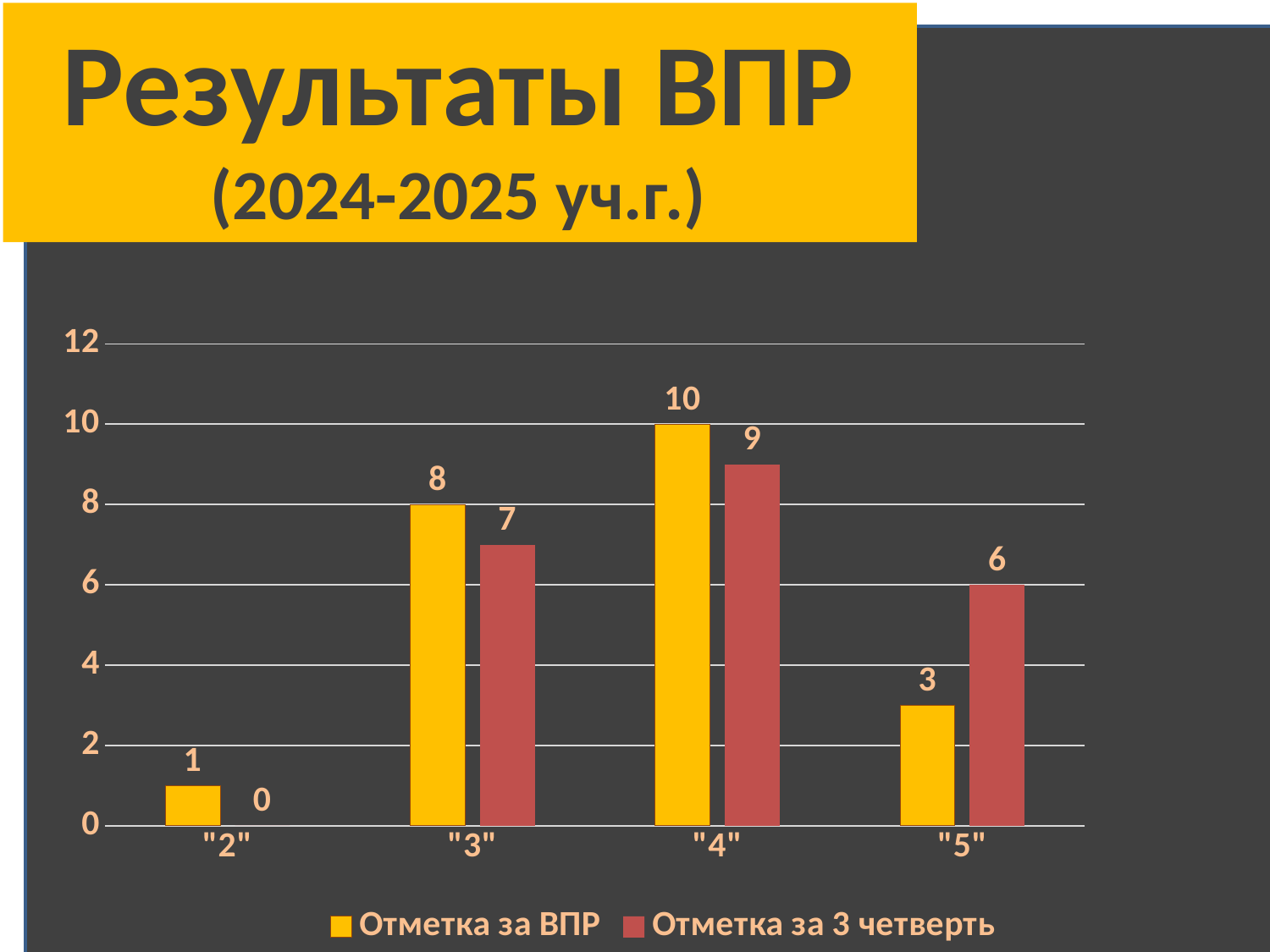
What is the value of "Отметка за 3 четверть" for category "2"? 0 What kind of chart is shown on the slide? bar chart What is the value of "Отметка за 3 четверть" for category "3"? 7 How many categories are shown on the x axis? 4 What is the title of the slide? Результаты ВПР (2024-2025 уч.г.) How many series does the legend list? 2 Is the value of "Отметка за 3 четверть" for category "4" greater or less than 8? greater For category "3", which is larger: "Отметка за ВПР" or "Отметка за 3 четверть"? Отметка за ВПР What is the value of "Отметка за ВПР" for category "4"? 10 Which category has the highest value for "Отметка за ВПР"? "4" What is the difference between "Отметка за ВПР" and "Отметка за 3 четверть" for category "5"? 3 Which category has the lowest value for "Отметка за 3 четверть"? "2"